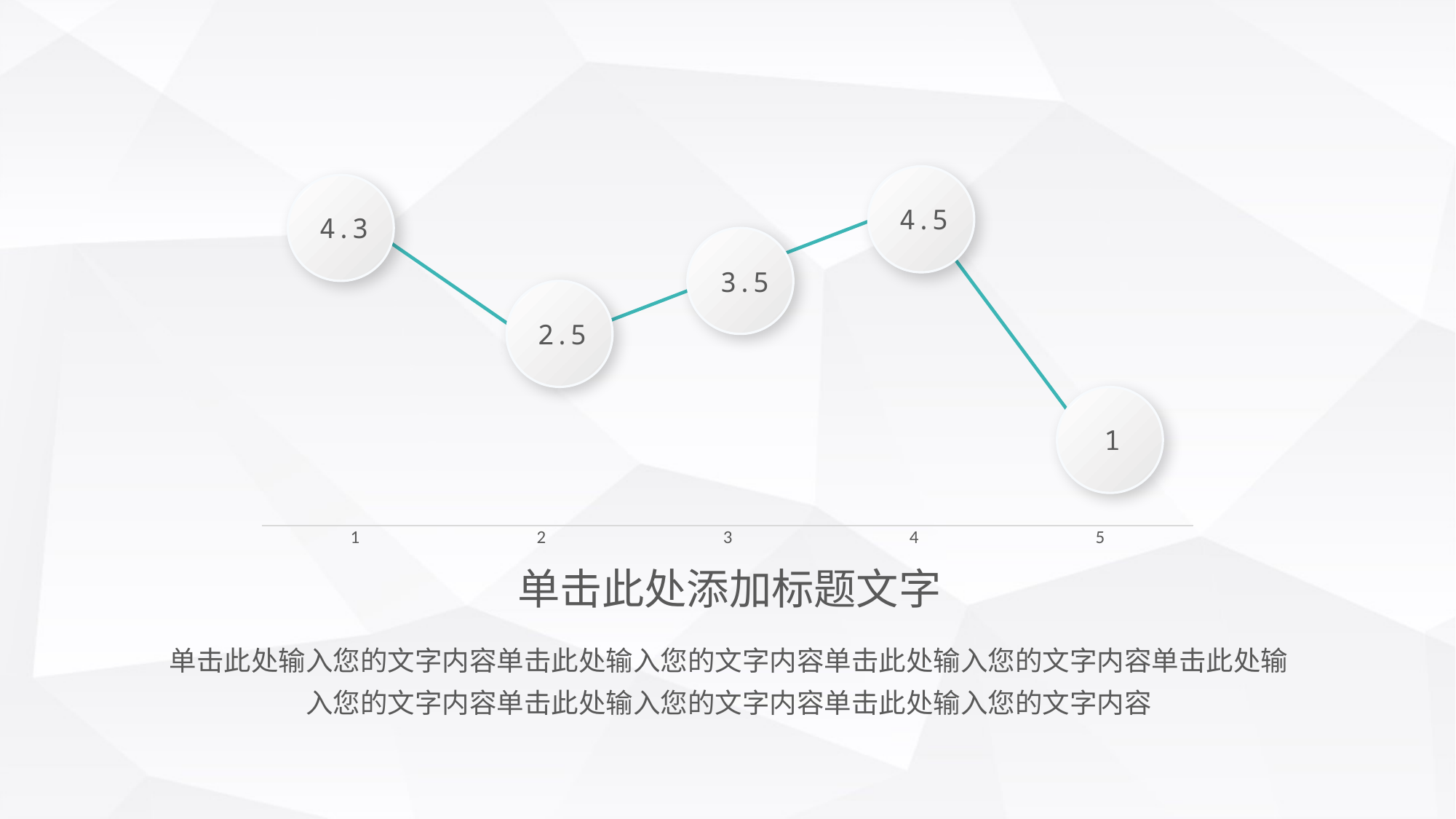
Which is larger, the value at category 3 or the value at category 2? category 3 What is the value at category 5? 1 What is the value at category 2? 2.5 What is the difference between the values at category 4 and category 5? 3.5 Which category has the highest value? 4 Which category has the lowest value? 5 How many data points are plotted on the chart? 5 What is the value at category 4? 4.5 What is the value at category 3? 3.5 What is the value at category 1? 4.3 What is the difference between the values at category 1 and category 2? 1.8 What kind of chart is shown on the slide? line chart